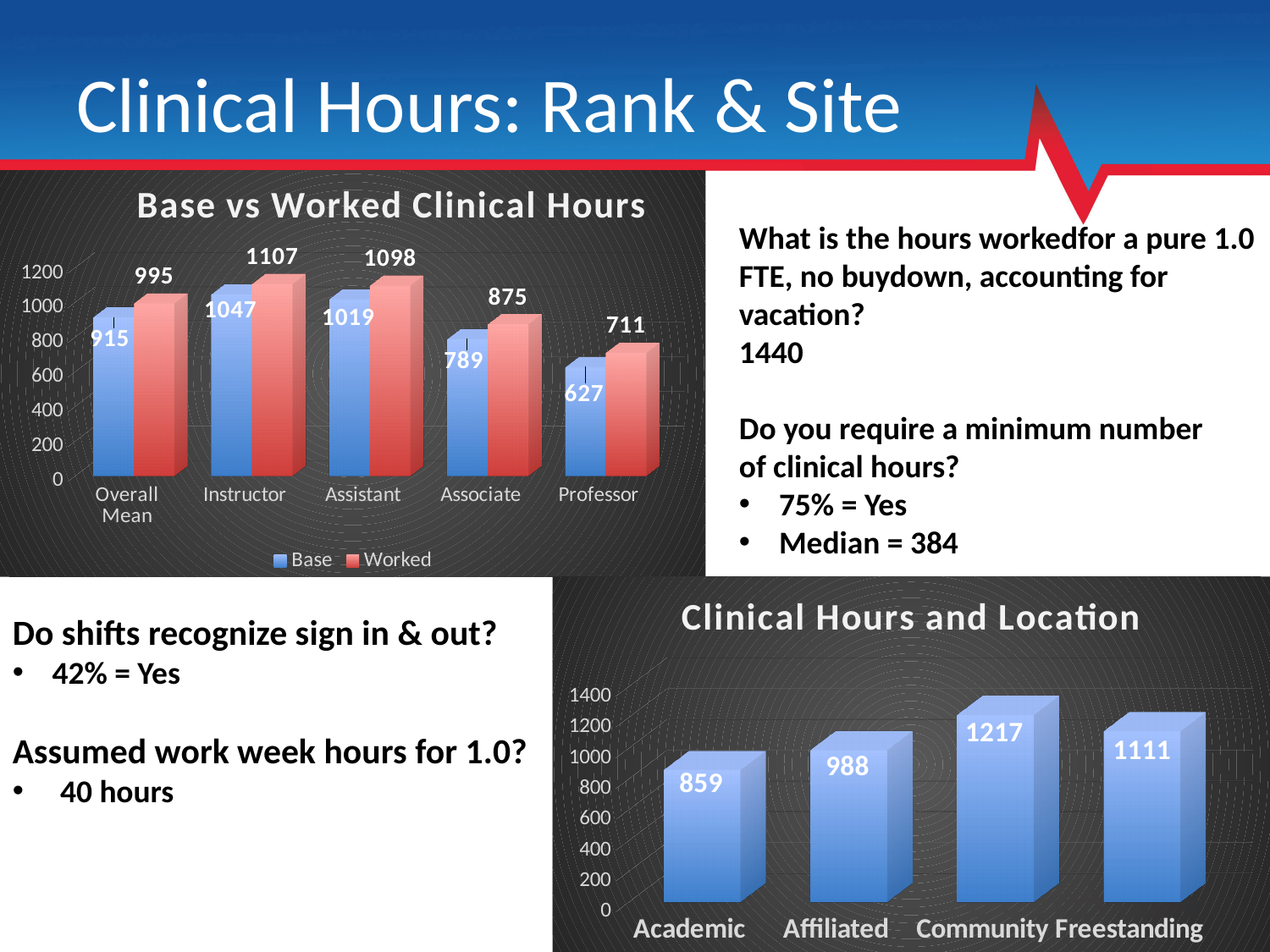
In the 'Base vs Worked Clinical Hours' chart, is the Base value for Assistant larger or smaller than the Base value for Instructor? smaller In the 'Clinical Hours and Location' chart, which category has the highest value? Community How many series does the legend of the 'Base vs Worked Clinical Hours' chart list? 2 How many categories are shown on the x axis of the 'Base vs Worked Clinical Hours' chart? 5 In the 'Base vs Worked Clinical Hours' chart, what is the Base value for Professor? 627 In the 'Base vs Worked Clinical Hours' chart, what is the difference between the Worked and Base values for Associate? 86 What kind of chart is the 'Clinical Hours and Location' chart? bar chart In the 'Clinical Hours and Location' chart, what is the value for Affiliated? 988 In the 'Clinical Hours and Location' chart, is the value for Freestanding greater or less than 1000? greater In the 'Base vs Worked Clinical Hours' chart, what is the Worked value for Instructor? 1107 In the 'Base vs Worked Clinical Hours' chart, which category has the lowest Worked value? Professor In the 'Clinical Hours and Location' chart, what is the difference between the Community and Academic values? 358